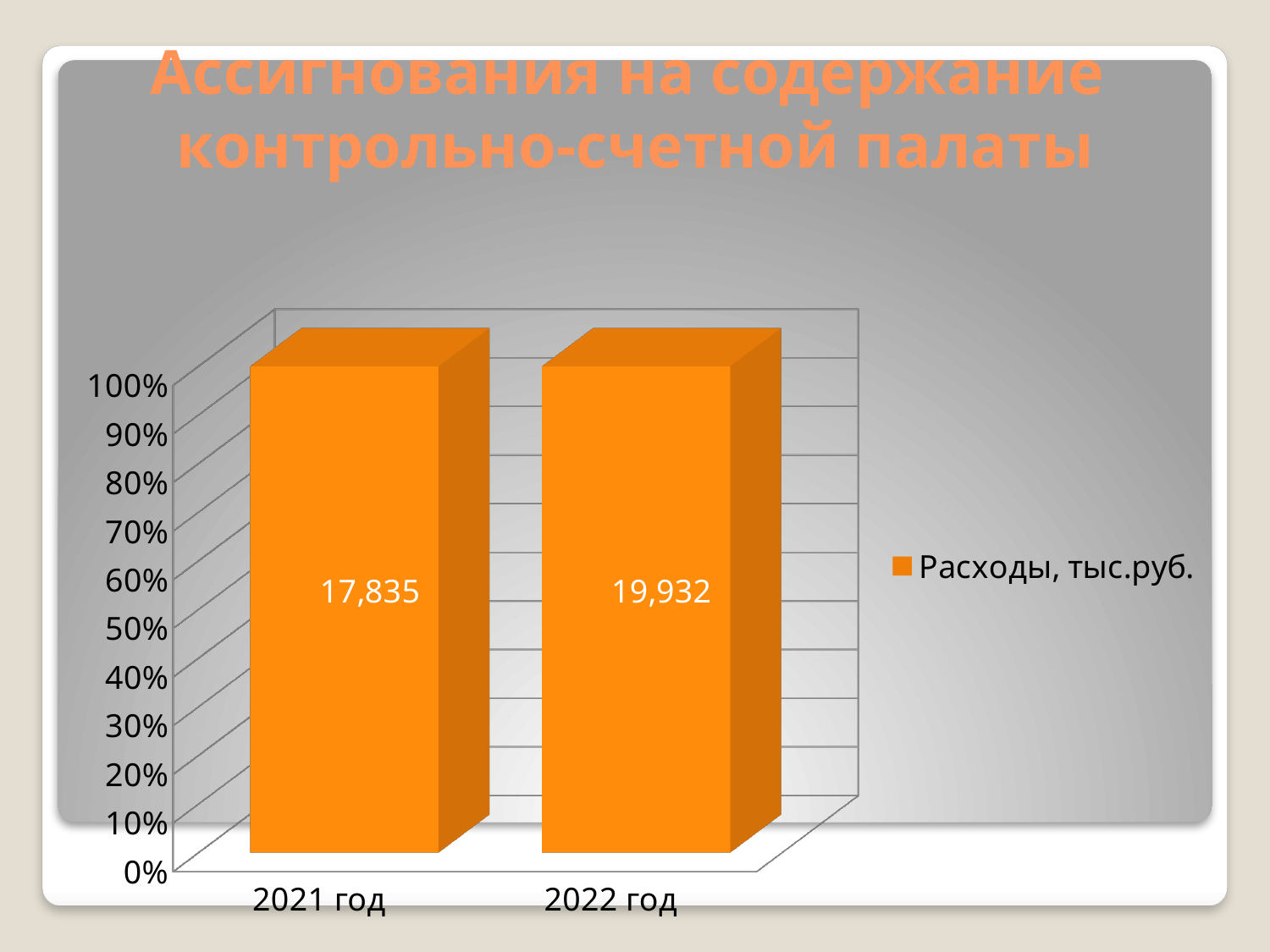
Which year has the lower labelled value? 2021 год What is the value labelled on the bar for 2021 год? 17,835 How many series does the legend list? 1 Is the labelled value for 2021 год larger or smaller than the value for 2022 год? smaller What is the difference between the labelled values for 2022 год and 2021 год? 2,097 What is the title of the chart? Ассигнования на содержание контрольно-счетной палаты How many categories (years) are shown on the x axis? 2 Do the labelled values rise or fall from 2021 год to 2022 год? rise Which year has the higher labelled value, 2021 год or 2022 год? 2022 год What is the value labelled on the bar for 2022 год? 19,932 What kind of chart is shown on the slide? bar chart What is the legend entry for the series shown? Расходы, тыс.руб.